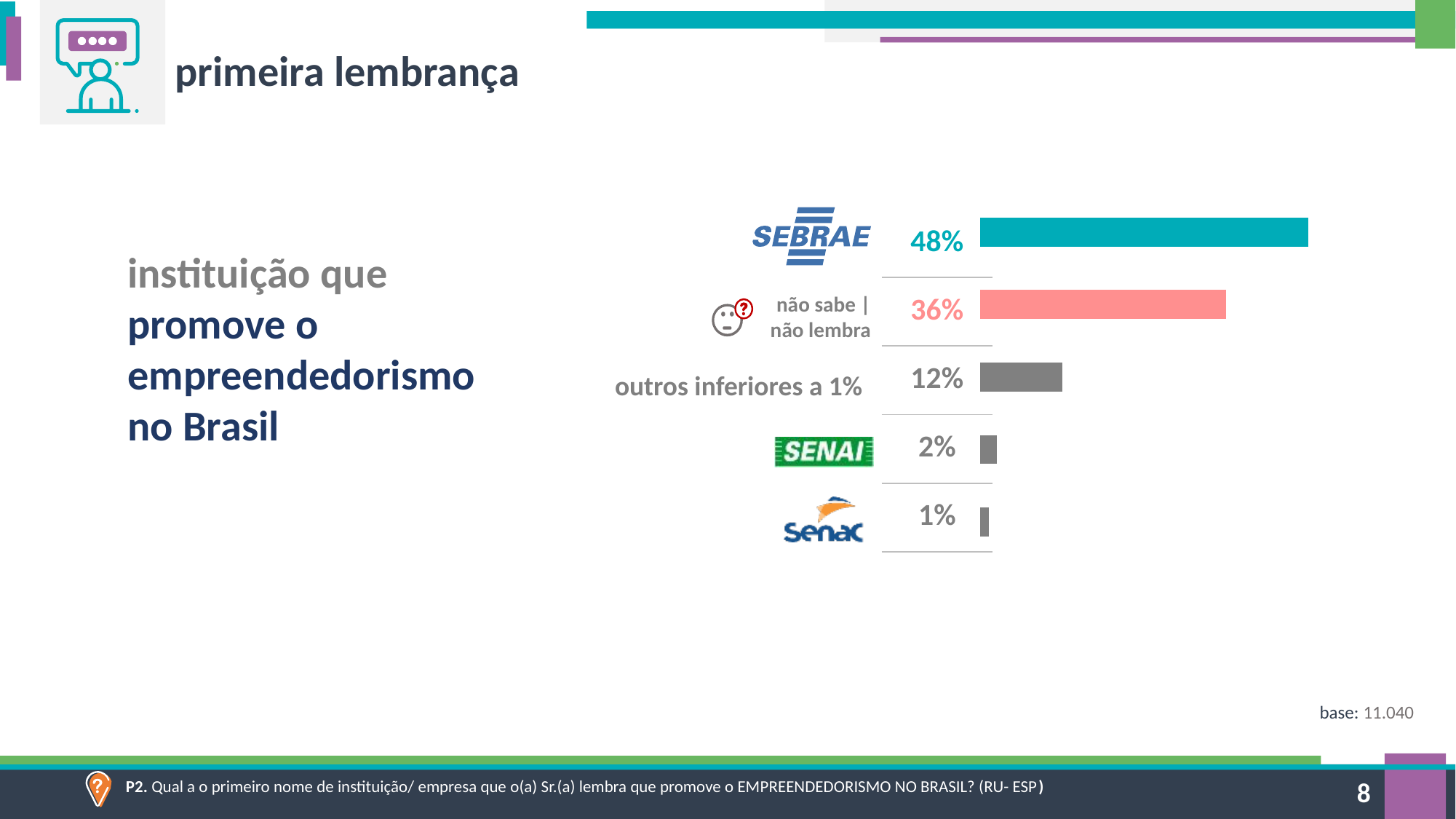
How many categories are shown in the chart? 5 Which category has the lowest value? Senac Which category has the highest value? SEBRAE What percentage is shown for 'não sabe | não lembra'? 36% What percentage is shown for SENAI? 2% What percentage is shown for Senac? 1% What kind of chart is shown on the slide? bar chart What percentage is shown for 'outros inferiores a 1%'? 12% What is the difference between the SEBRAE value and the 'não sabe | não lembra' value? 12% Which is larger, the value for SENAI or the value for Senac? SENAI What percentage is shown for SEBRAE? 48% What is the base (sample size) shown on the slide? 11.040